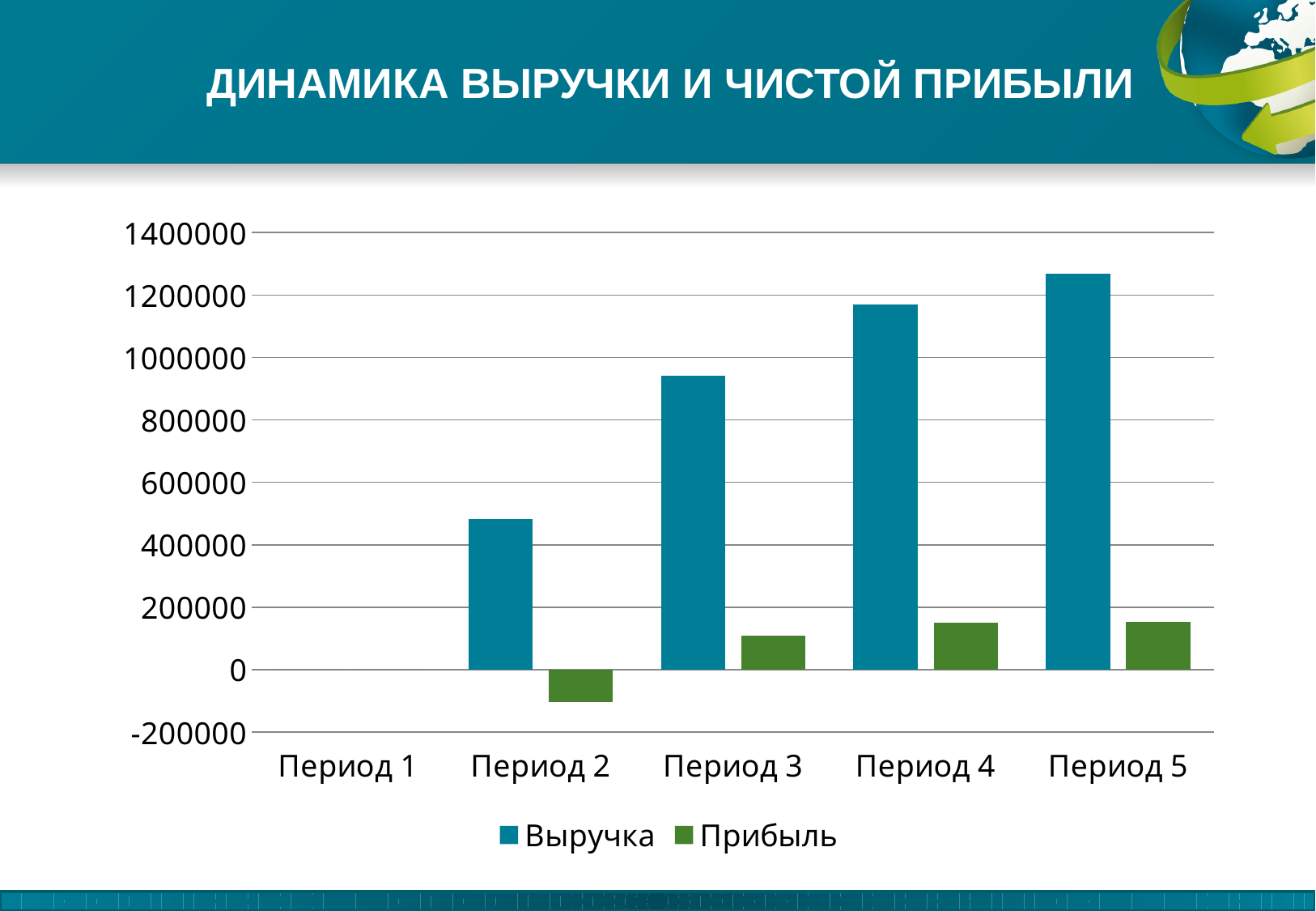
What is the title of the slide? ДИНАМИКА ВЫРУЧКИ И ЧИСТОЙ ПРИБЫЛИ Is the Выручка for Период 4 greater or less than 1000000? greater How many periods are shown on the x axis? 5 How many series does the legend list? 2 Is the Прибыль for Период 2 greater or less than 0? less Which period has the lowest Прибыль? Период 2 What kind of chart is shown on the slide? bar chart Is the Выручка for Период 2 greater or less than 400000? greater Which period has the highest Выручка? Период 5 Does Выручка rise or fall from Период 2 to Период 5? rises Which is larger, the Выручка for Период 3 or for Период 4? Период 4